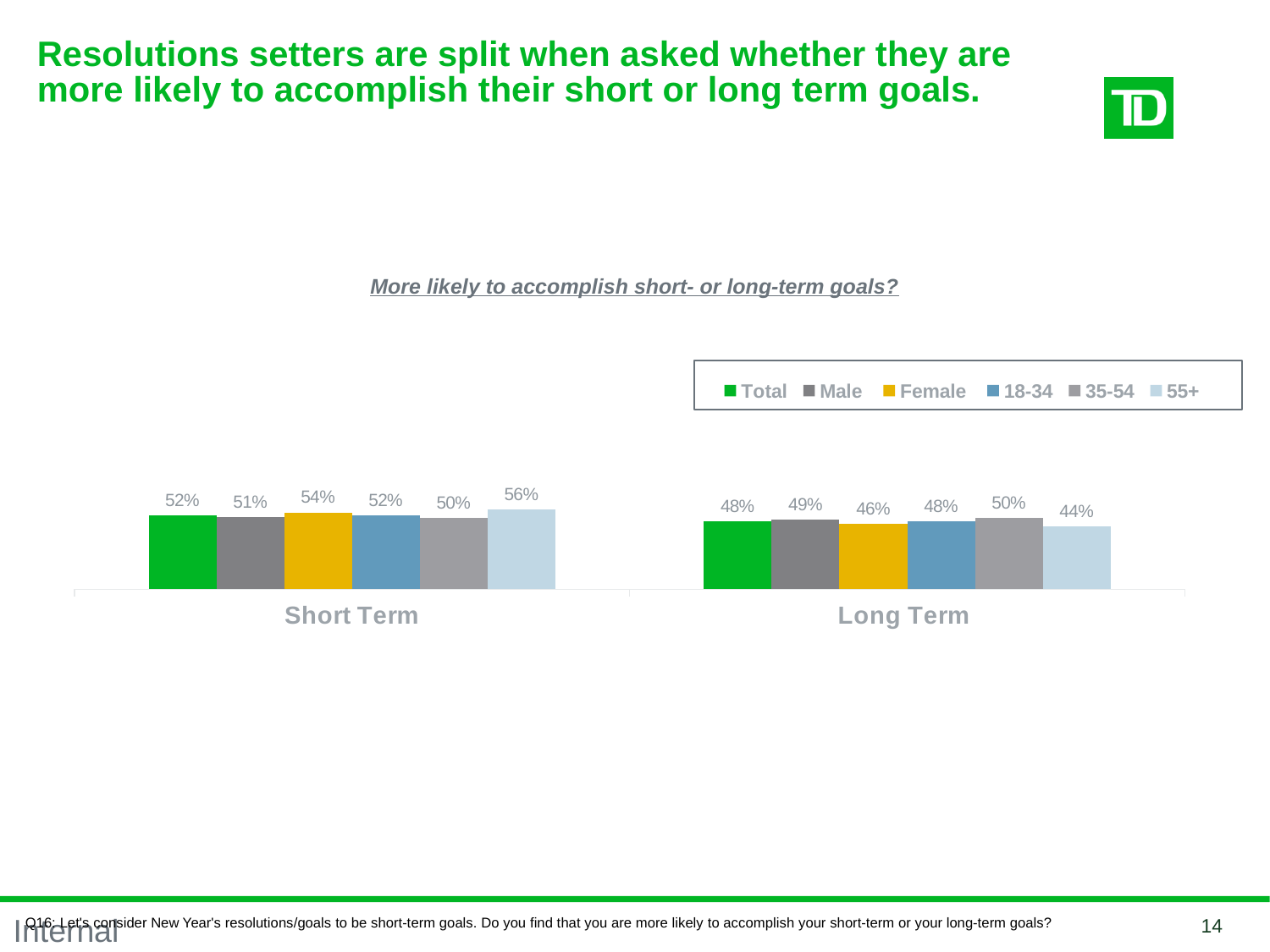
What is the title of the chart? More likely to accomplish short- or long-term goals? What is the value for 35-54 in the Long Term category? 50% What is the difference between the 55+ values for Short Term and Long Term? 12 percentage points How many categories are shown on the x axis? 2 What kind of chart is shown on the slide? Bar chart What is the value for Female in the Long Term category? 46% What is the value for Total in the Short Term category? 52% Which is larger, the Female value for Short Term or the Female value for Long Term? Short Term Which series has the highest value in the Short Term category? 55+ What is the value for 55+ in the Short Term category? 56% How many series does the legend list? 6 Which series has the lowest value in the Long Term category? 55+